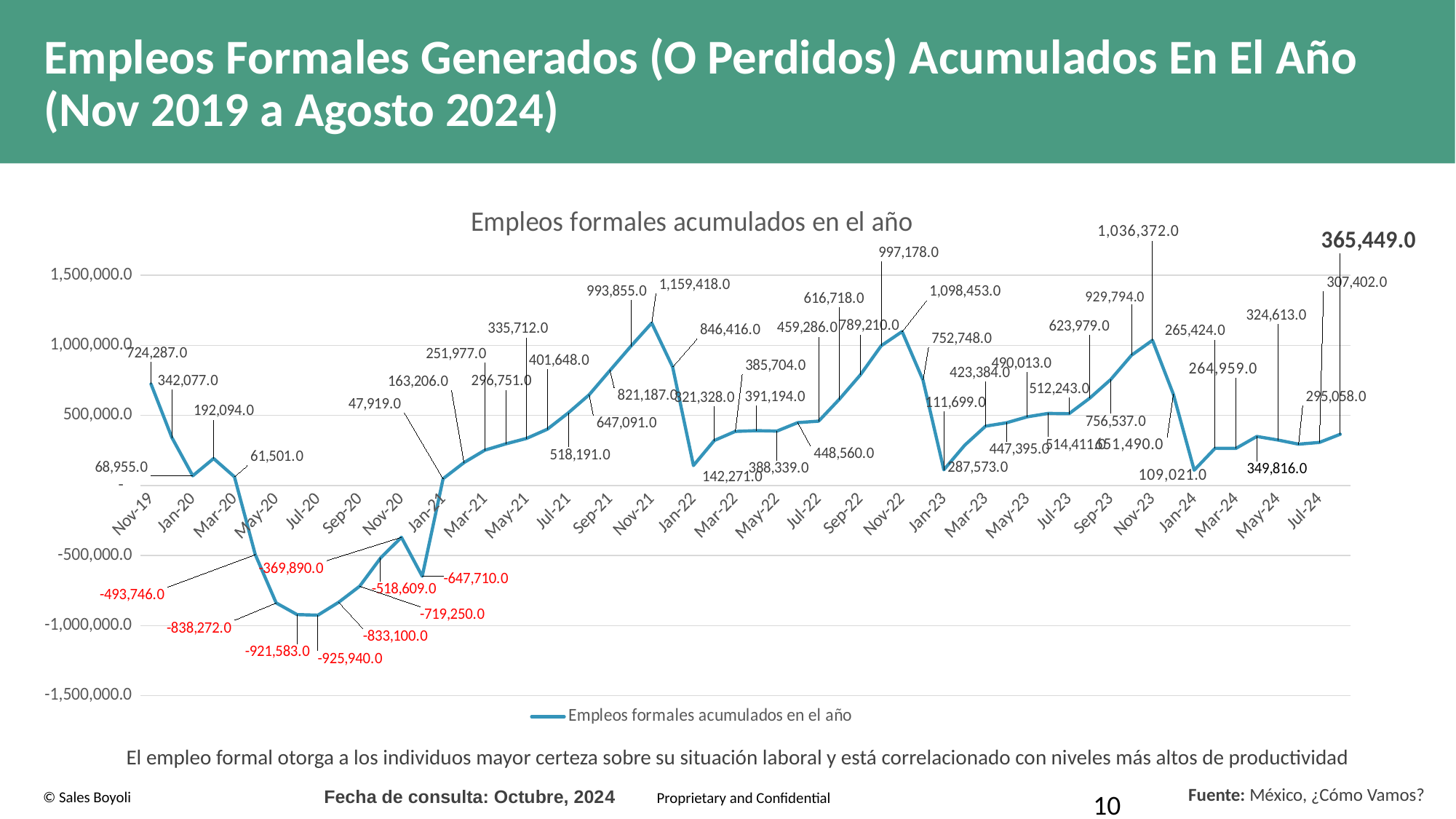
Is the value for Nov-21 greater or less than 1,000,000? greater Which is larger, the Nov-21 peak of 1,159,418.0 or the Nov-22 peak of 1,098,453.0? Nov-21 (1,159,418.0) What is the value for Nov-19, the first point on the chart? 724,287.0 What kind of chart is shown on the slide? line chart What is the difference between the highest value (1,159,418.0) and the lowest value (-925,940.0) on the chart? 2,085,358.0 What is the title of the chart? Empleos formales acumulados en el año What is the highest value plotted on the chart, and in which month does it occur? 1,159,418.0 in Nov-21 Is the value for Jan-22 greater or less than 500,000? less What is the lowest value plotted on the chart? -925,940.0 How many series does the legend list? 1 What is the value of the last point on the chart (Aug-24), shown in bold? 365,449.0 Do the values rise or fall from Jan-21 to Nov-21? rise